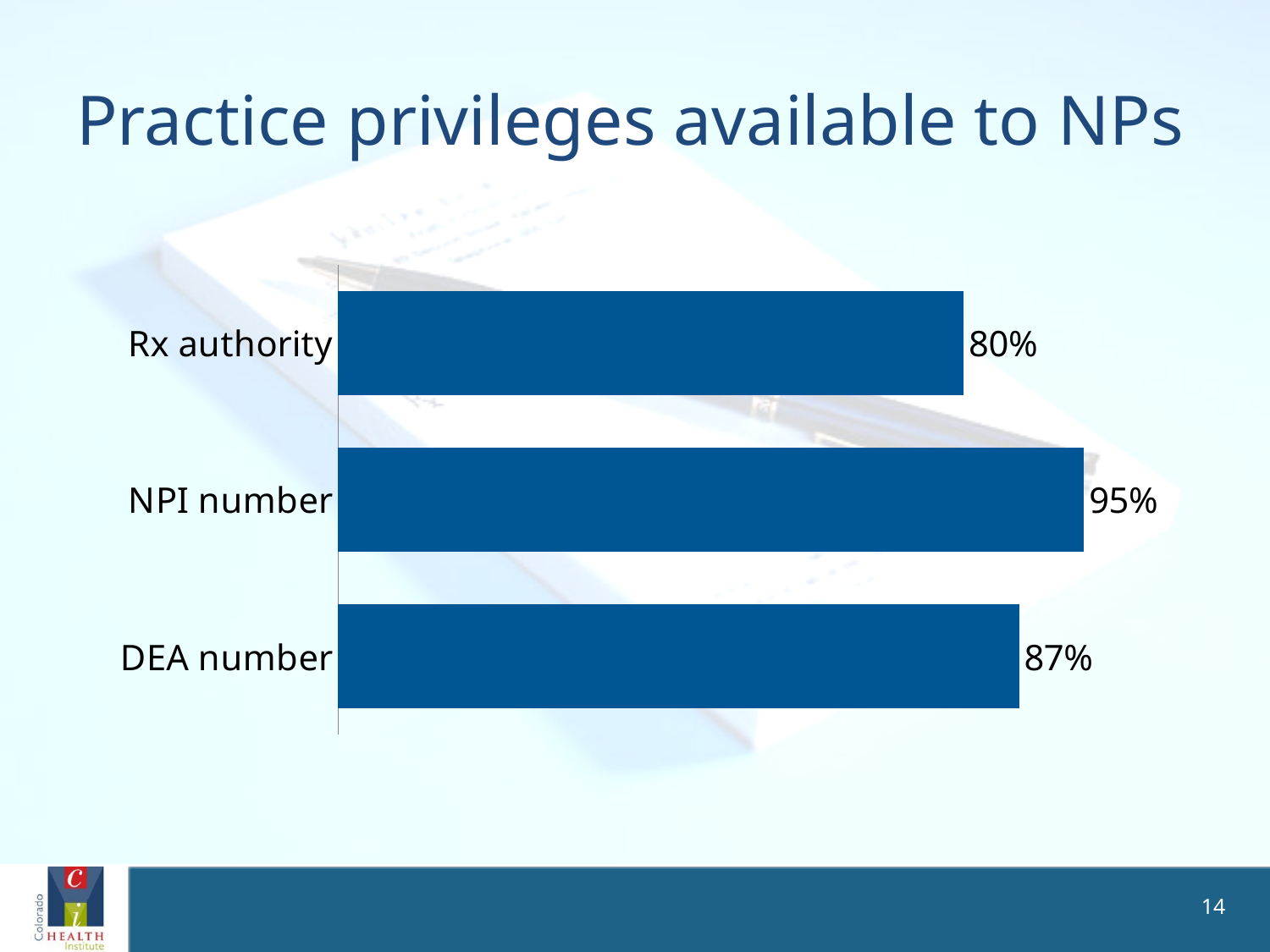
What is the value for DEA number? 87% What is the value for Rx authority? 80% What colour are the bars in the chart? Blue What is the difference between the values for DEA number and Rx authority? 7% What kind of chart is shown on the slide? Bar chart What is the title of the slide? Practice privileges available to NPs How many categories are shown in the chart? 3 Which is larger, the value for DEA number or the value for NPI number? NPI number What is the value for NPI number? 95% Which category has the lowest value? Rx authority Which category has the highest value? NPI number What is the difference between the values for NPI number and Rx authority? 15%